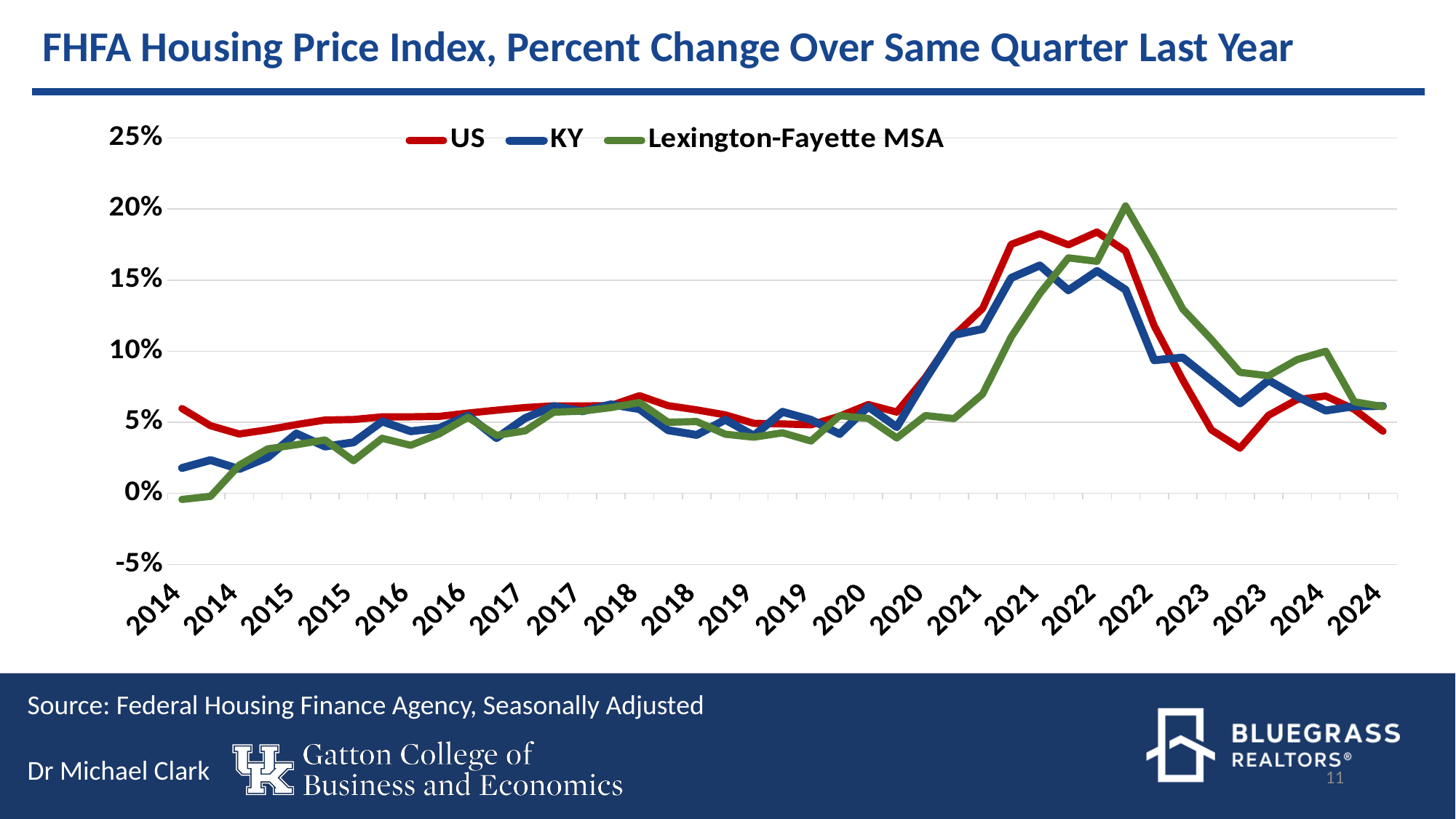
At the first 2014 point, which series has the lowest value? Lexington-Fayette MSA Is the peak value of the Lexington-Fayette MSA line greater or less than 15%? greater Is the value for KY at the first 2014 point greater or less than 5%? less Which colour is used for the Lexington-Fayette MSA line? Green Which series reaches the highest peak value on the chart? Lexington-Fayette MSA How many series does the legend list? 3 Is the value for US at the first 2014 point greater or less than 5%? greater What is the title of the chart? FHFA Housing Price Index, Percent Change Over Same Quarter Last Year What kind of chart is shown on the slide? Line chart At the first 2014 point, is the US value or the KY value larger? US Do the values for all three series rise or fall between 2020 and 2021? rise